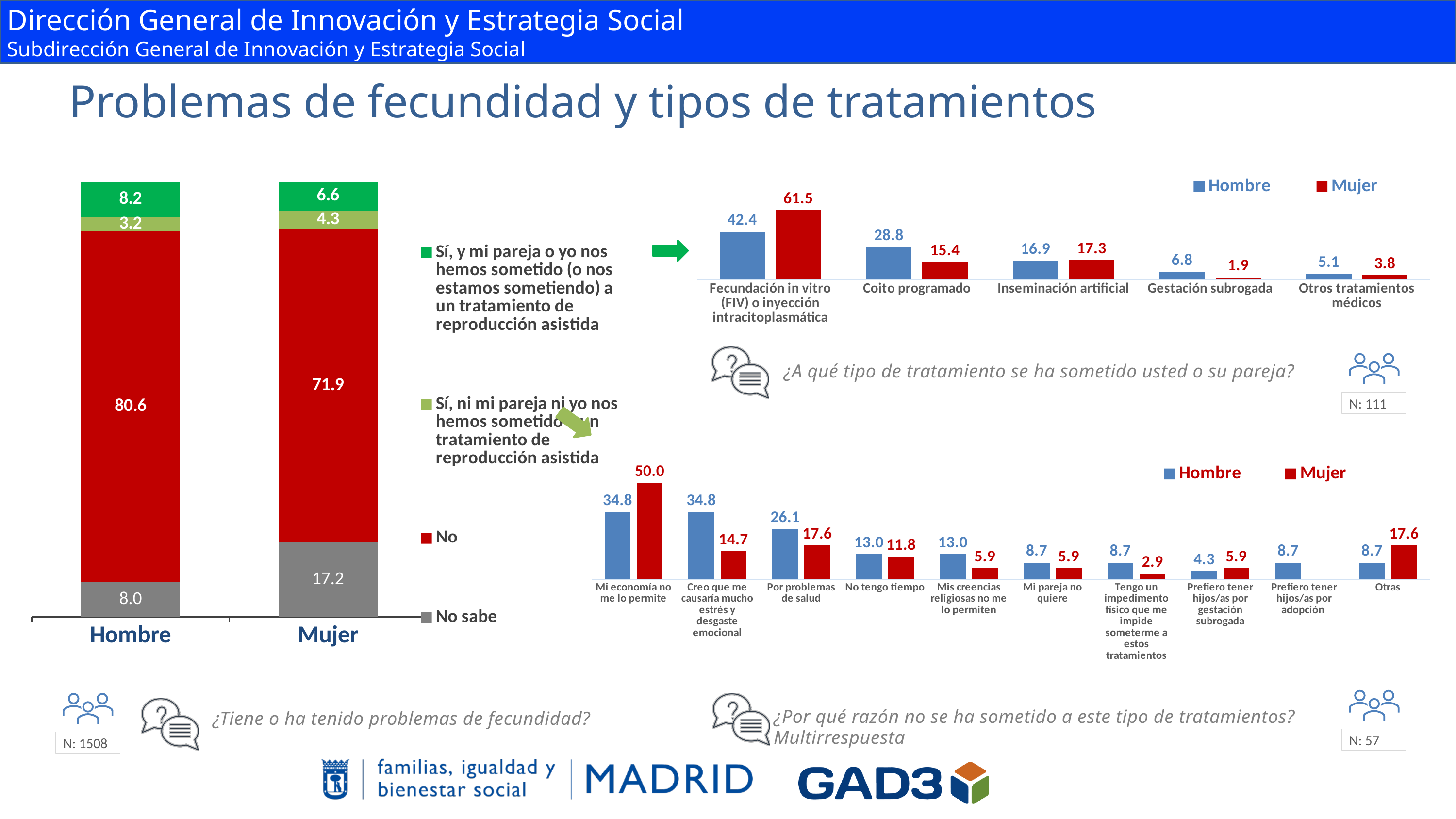
In the top-right chart on treatment types, what is the Mujer value for 'Fecundación in vitro (FIV) o inyección intracitoplasmática'? 61.5 In the stacked bar chart on the left, what is the value of the 'No sabe' segment for Mujer? 17.2 In the bottom-right chart on reasons for not undergoing treatment, how many reason categories are shown? 10 In the stacked bar chart on the left, how many segments does the legend list? 4 In the bottom-right chart on reasons for not undergoing treatment, what is the difference between the Hombre and Mujer values for 'Creo que me causaría mucho estrés y desgaste emocional'? 20.1 In the stacked bar chart on the left, what is the difference between the 'No' values for Hombre and Mujer? 8.7 In the top-right chart on treatment types, how many treatment categories are shown? 5 What type of chart is the top-right chart on treatment types? Bar chart In the top-right chart on treatment types, which is larger for 'Coito programado', Hombre or Mujer? Hombre In the top-right chart on treatment types, which category has the lowest Mujer value? Gestación subrogada In the bottom-right chart on reasons for not undergoing treatment, what is the Mujer value for 'Mi economía no me lo permite'? 50.0 In the stacked bar chart on the left, what is the value of the 'No' segment for Hombre? 80.6